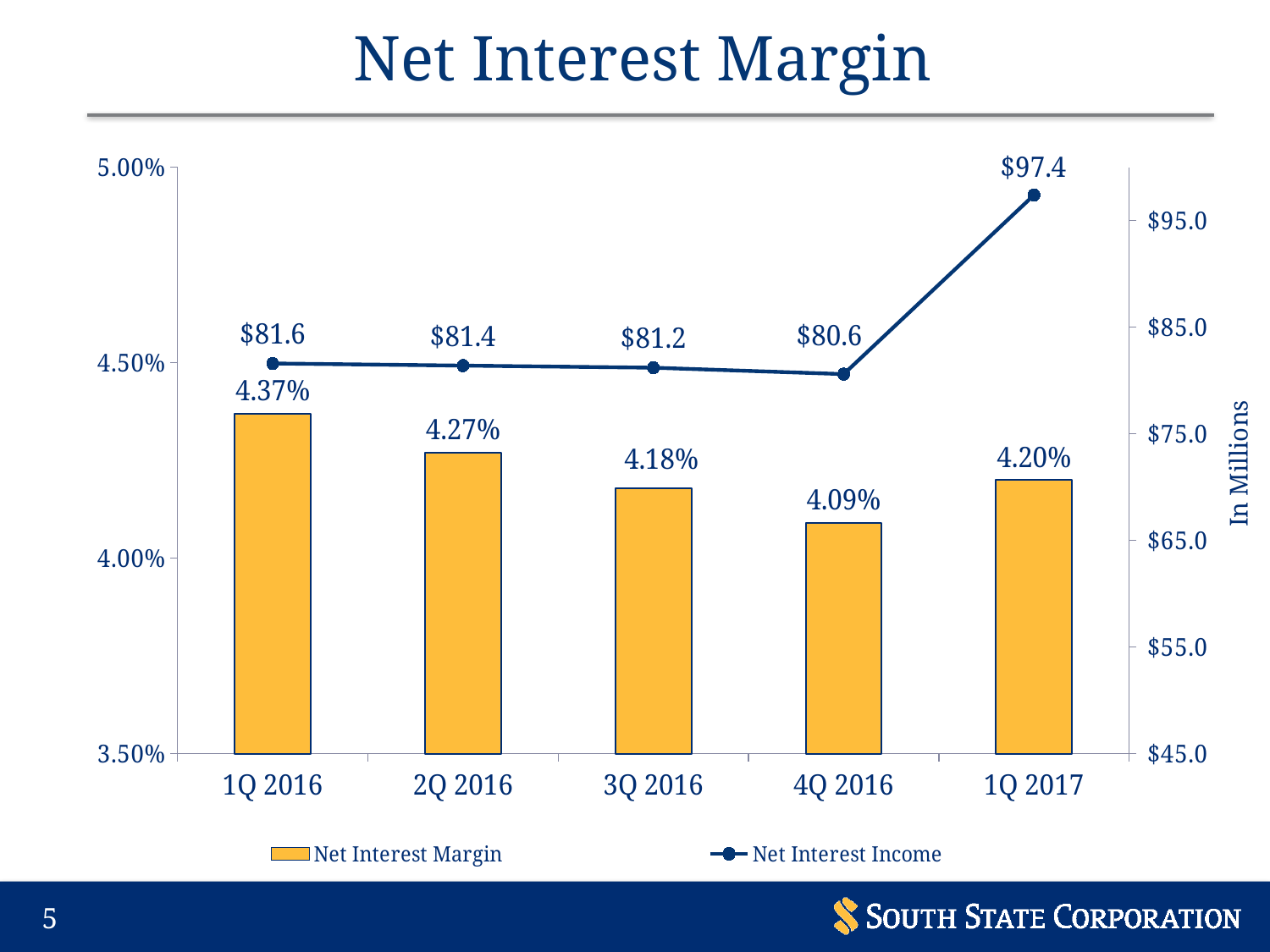
Which is larger, the Net Interest Margin for 2Q 2016 or for 1Q 2017? 2Q 2016 What is the difference in Net Interest Margin between 1Q 2016 and 4Q 2016? 0.28% What is the Net Interest Income for 4Q 2016? $80.6 What is the Net Interest Income for 1Q 2017? $97.4 How many quarters are shown on the x axis? 5 What is the Net Interest Margin for 1Q 2016? 4.37% Which quarter has the lowest Net Interest Margin? 4Q 2016 Which quarter has the highest Net Interest Income? 1Q 2017 What is the difference in Net Interest Income between 1Q 2017 and 4Q 2016? $16.8 How many series does the legend list? 2 What is the title of the chart? Net Interest Margin Does the Net Interest Margin rise or fall from 1Q 2016 to 4Q 2016? fall